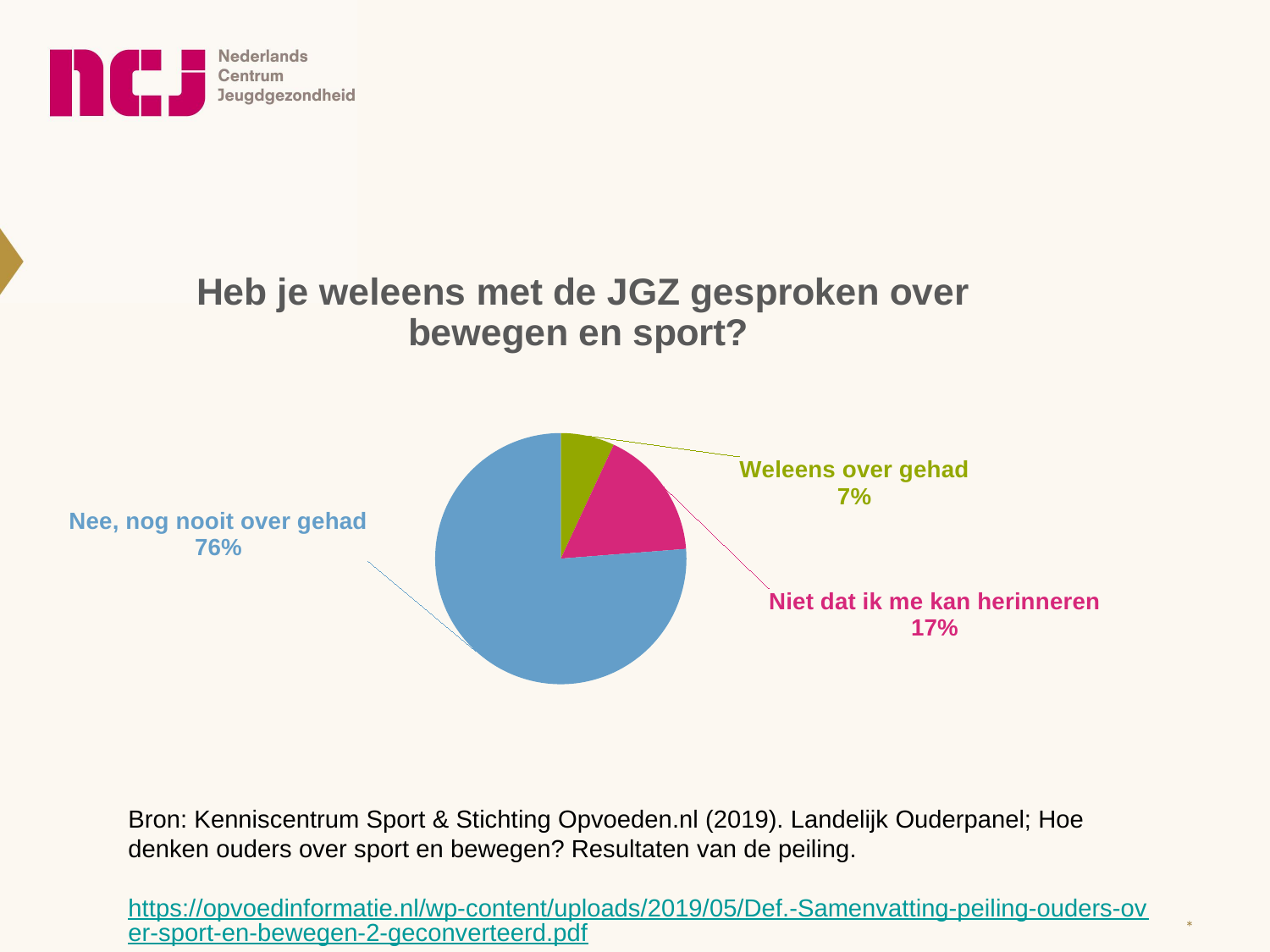
Which answer has the largest share of the pie? Nee, nog nooit over gehad What kind of chart is shown on the slide? pie chart What percentage of respondents answered "Weleens over gehad"? 7% What colour is the slice for "Weleens over gehad"? green What is the difference in percentage points between "Nee, nog nooit over gehad" and "Niet dat ik me kan herinneren"? 59 What is the title of the chart? Heb je weleens met de JGZ gesproken over bewegen en sport? How many slices does the pie chart have? 3 What percentage of respondents answered "Nee, nog nooit over gehad"? 76% Which is larger: the share for "Niet dat ik me kan herinneren" or the share for "Weleens over gehad"? Niet dat ik me kan herinneren What is the difference in percentage points between "Niet dat ik me kan herinneren" and "Weleens over gehad"? 10 What percentage of respondents answered "Niet dat ik me kan herinneren"? 17% Which answer has the smallest share of the pie? Weleens over gehad